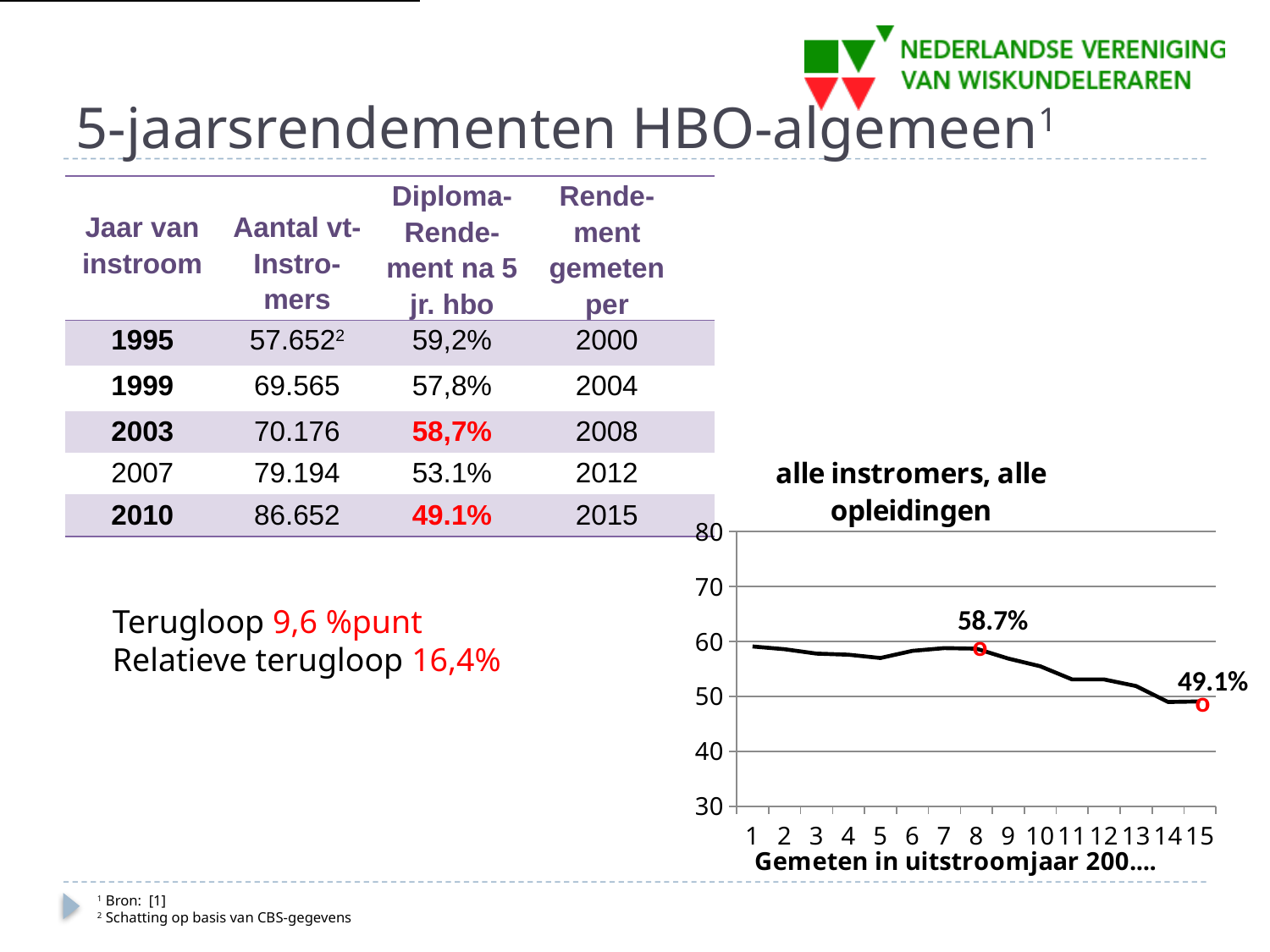
What is the x-axis label of the chart? Gemeten in uitstroomjaar 200.... What value is labelled at point 15 on the chart? 49.1% What kind of chart is shown on the slide? line chart What is the title of the chart? alle instromers, alle opleidingen How many points are marked along the x axis of the chart? 15 What value is labelled at point 8 on the chart? 58.7% Which labelled value is larger, the one at point 8 or the one at point 15? point 8 Do the values on the chart generally rise or fall from point 1 to point 15? fall What is the difference between the labelled values at point 8 and point 15? 9.6 Is the value at point 1 greater or less than 50? greater Is the value at point 11 greater or less than 60? less